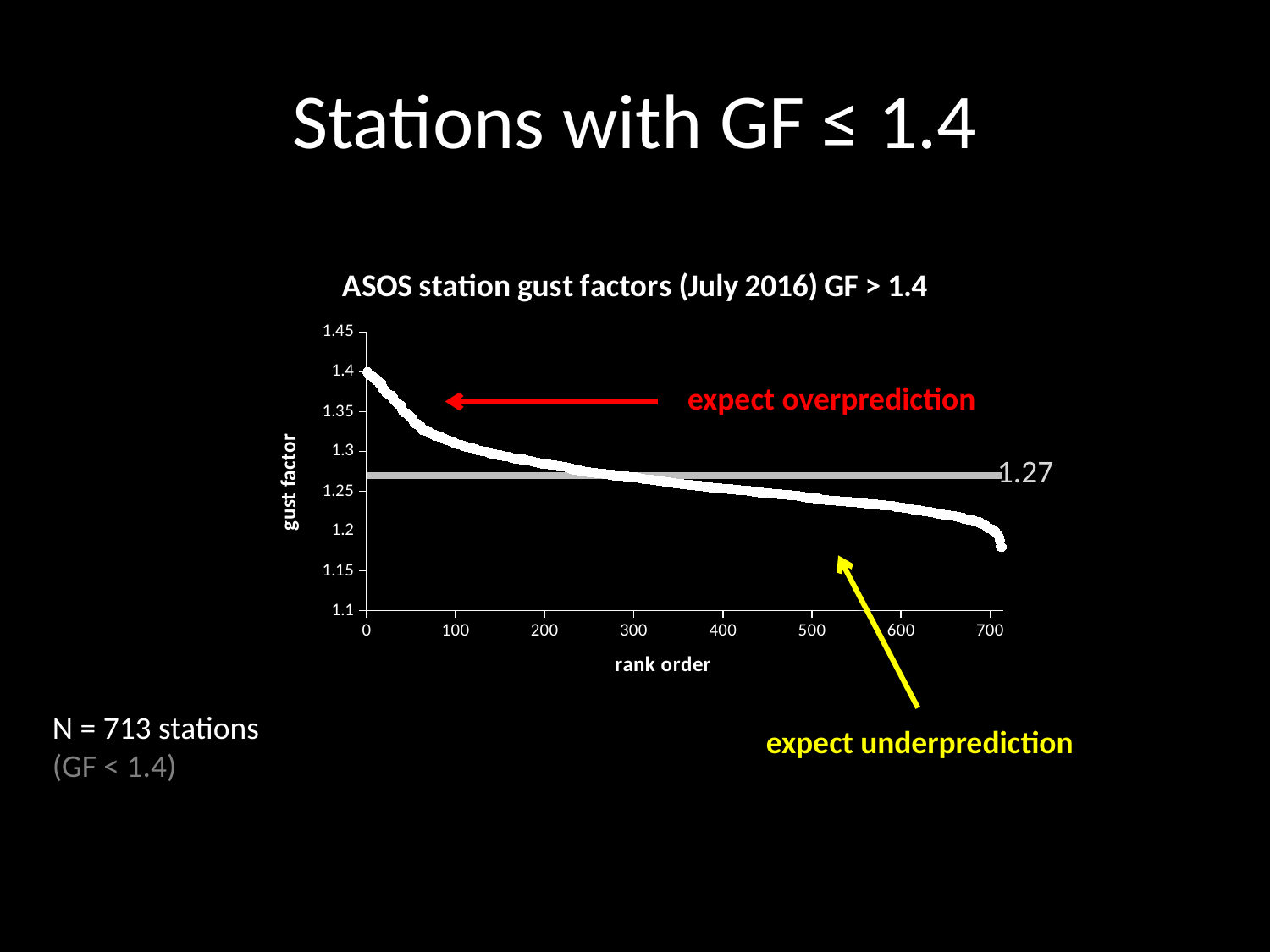
Is the gust factor at rank order 50 greater or less than 1.3? greater What kind of chart is shown on the slide? scatter chart Do the gust factor values rise or fall as rank order increases? fall What value is marked by the horizontal grey line on the chart? 1.27 Which has the higher gust factor, the station at rank order 100 or the station at rank order 500? rank order 100 Is the gust factor at rank order 0 greater or less than 1.35? greater How many stations are included in the chart according to the slide? 713 What is the label of the y axis? gust factor What is the highest value shown on the y axis of the chart? 1.45 Is the gust factor at rank order 600 greater or less than 1.25? less What is the title of the chart? ASOS station gust factors (July 2016) GF > 1.4